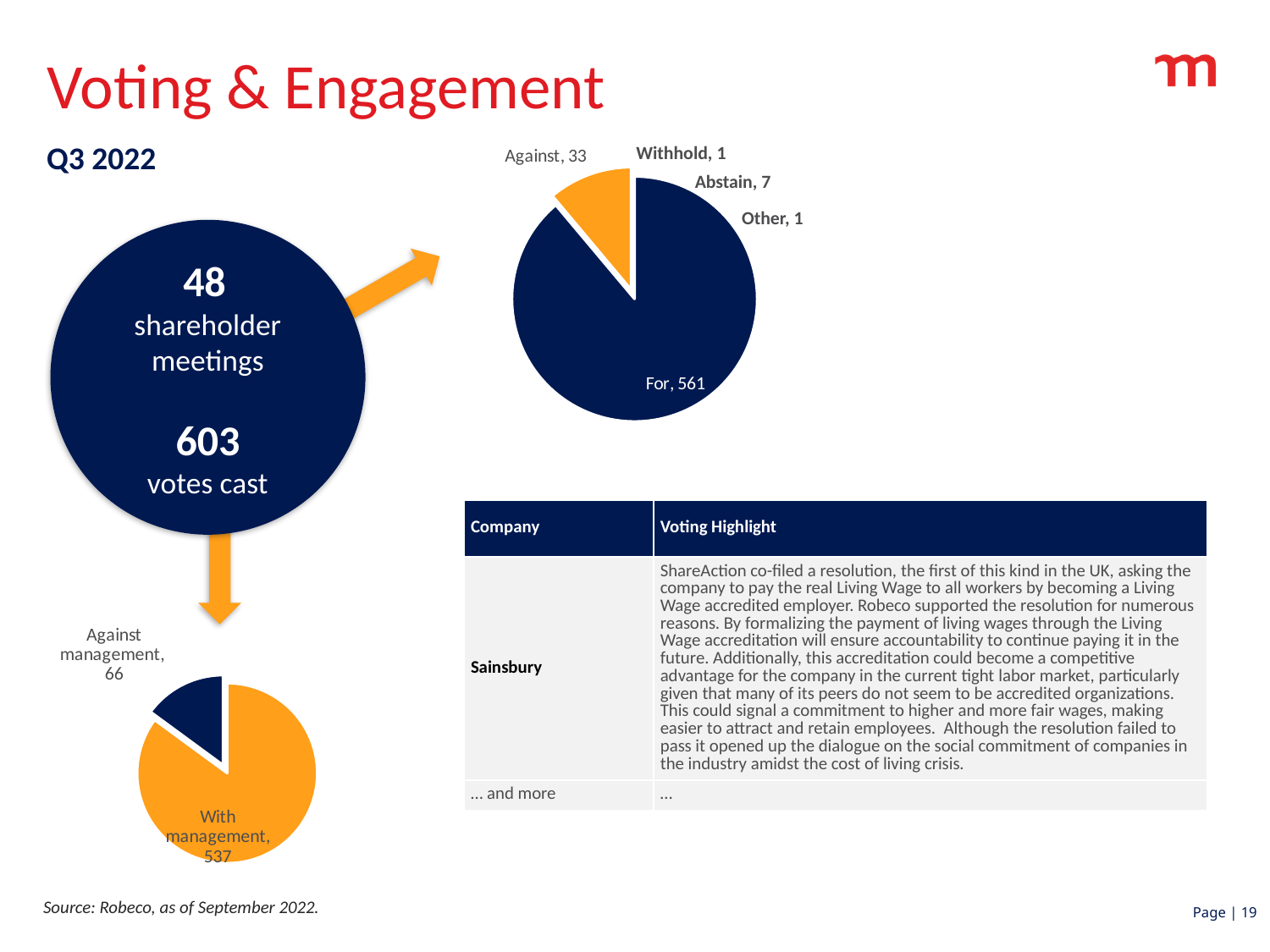
In the top-right pie chart, what is the difference between the "For" and "Against" values? 528 In the top-right pie chart, how many votes are labelled "For"? 561 In the top-right pie chart, what is the value for "Abstain"? 7 In the bottom-left pie chart, what is the value for "Against management"? 66 In the bottom-left pie chart, what is the value for "With management"? 537 What kind of chart is the bottom-left chart? Pie chart In the top-right pie chart, which is larger, "Abstain" or "Withhold"? Abstain In the bottom-left pie chart, how much larger is "With management" than "Against management"? 471 What is the total of the two slices in the bottom-left pie chart? 603 In the top-right pie chart, what is the value for "Against"? 33 In the top-right pie chart, which category has the largest slice? For